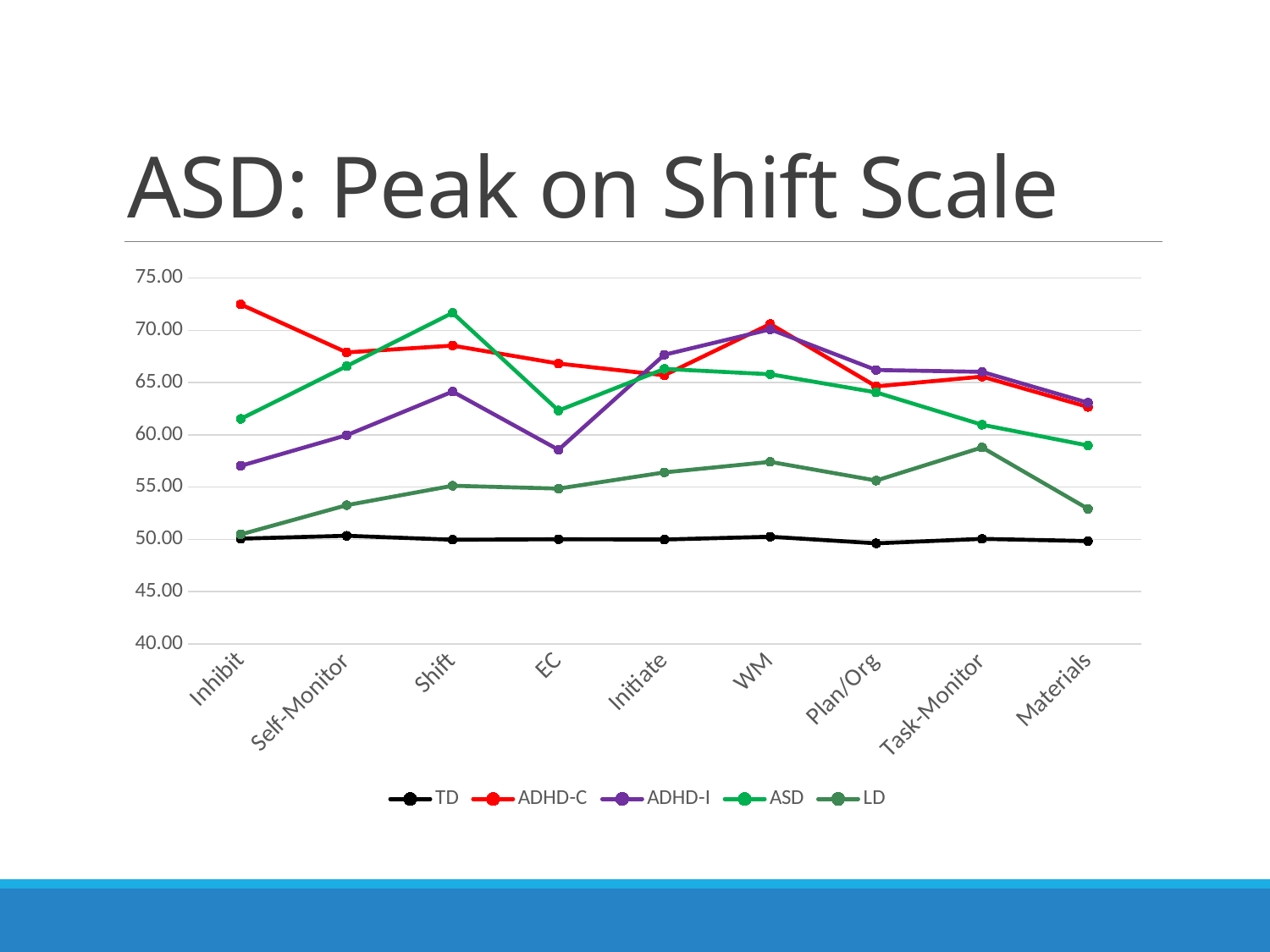
How many series does the legend list? 5 For the ADHD-I series, which category has the lowest value? Inhibit At Inhibit, which series has the larger value, ADHD-C or ASD? ADHD-C Is the ASD value for Shift greater or less than 70.00? greater Does the ASD series rise or fall from Initiate to Materials? fall Is the LD value for Inhibit greater or less than 55.00? less What kind of chart is shown on the slide? line chart At Shift, which series has the larger value, ASD or ADHD-C? ASD For the ASD series, which category has the highest value? Shift What is the title of the slide? ASD: Peak on Shift Scale How many categories are shown along the x axis? 9 For the ADHD-C series, which category has the highest value? Inhibit